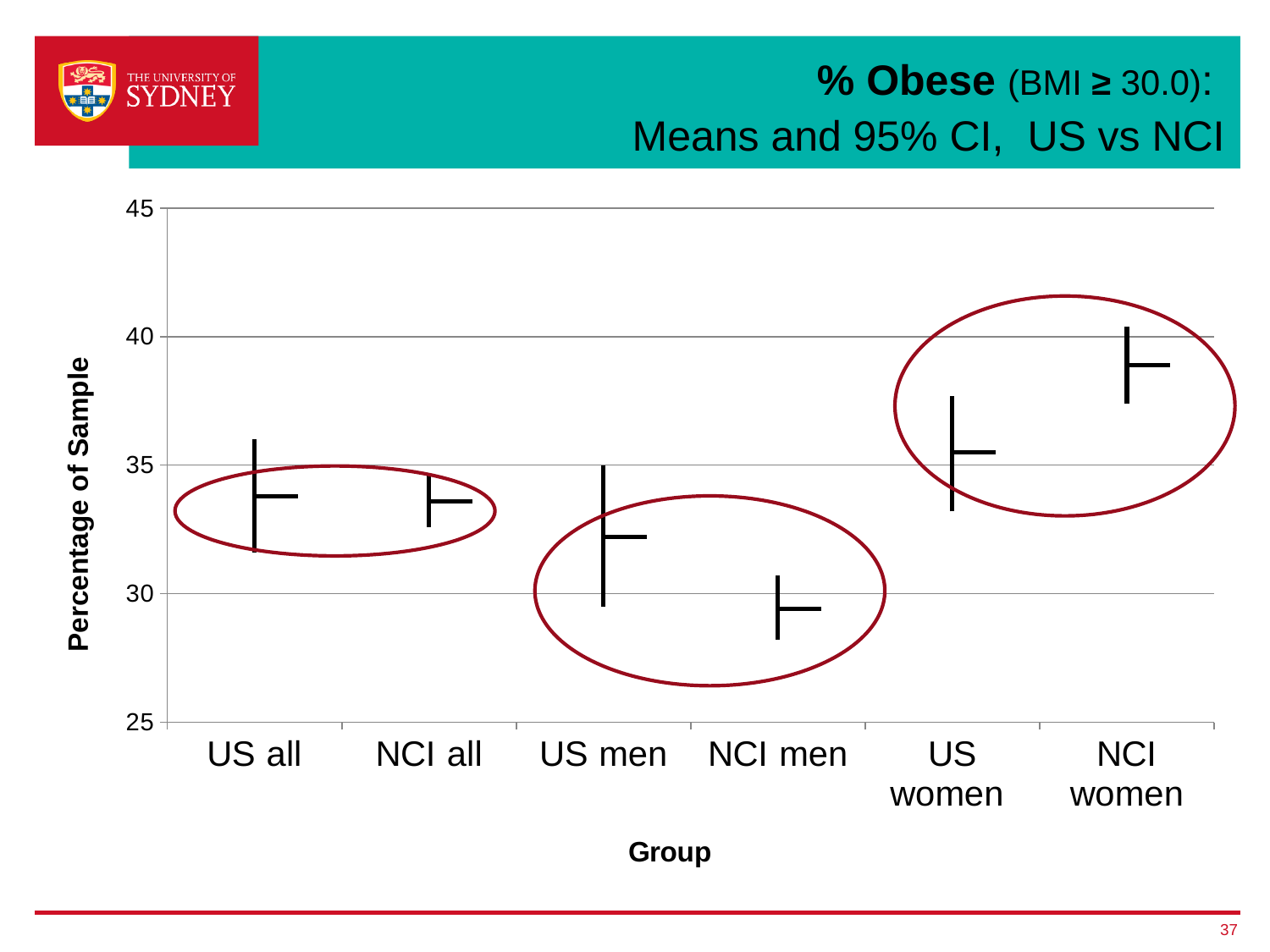
Is the mean value for NCI women greater or less than 35? greater What is the label of the y axis? Percentage of Sample Which group has the lowest mean percentage obese? NCI men Which group has the highest mean percentage obese? NCI women Is the mean value for US all greater or less than 30? greater Is the mean value for NCI men greater or less than 35? less How many red ellipses are drawn on the chart? 3 Which has the larger mean, US men or NCI men? US men How many groups are plotted on the x axis? 6 Which has the larger mean, US women or NCI women? NCI women